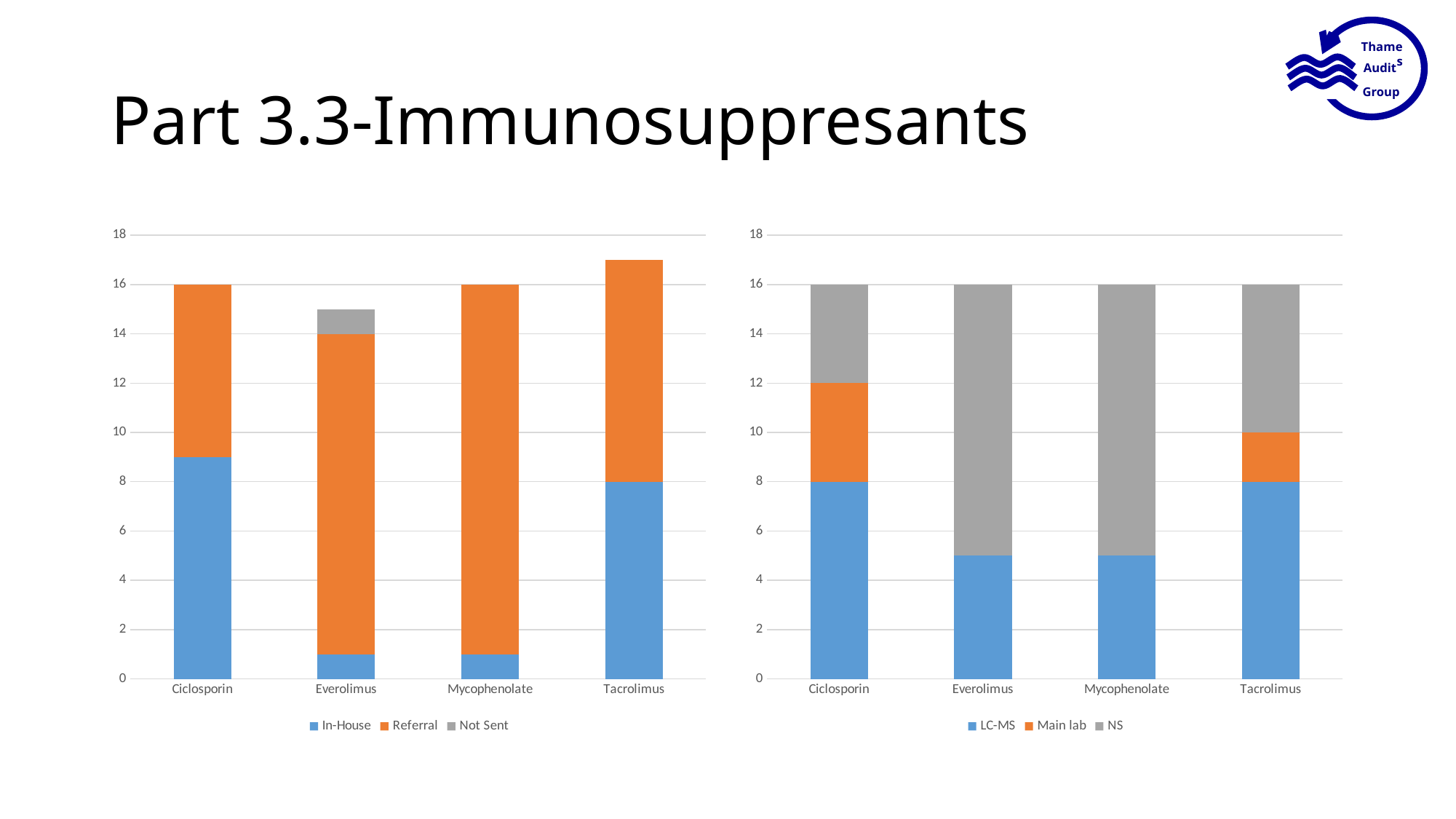
In the left chart, which category has the tallest stacked bar overall? Tacrolimus How many series does the legend of the left chart list? 3 In the left chart, what is the In-House value for Tacrolimus? 8 What kind of chart is the left chart on the slide? Stacked bar chart How many categories are shown on the x axis of the right chart? 4 In the left chart, what is the total height of the stacked bar for Ciclosporin? 16 What are the legend entries of the right chart? LC-MS, Main lab, NS In the right chart, is the LC-MS value for Mycophenolate greater or less than 4? greater In the right chart, what is the total height of the stacked bar for Everolimus? 16 In the right chart, which is larger: the LC-MS value for Ciclosporin or the LC-MS value for Everolimus? Ciclosporin In the left chart, is the In-House value for Everolimus greater or less than 2? less In the right chart, what is the LC-MS value for Ciclosporin? 8